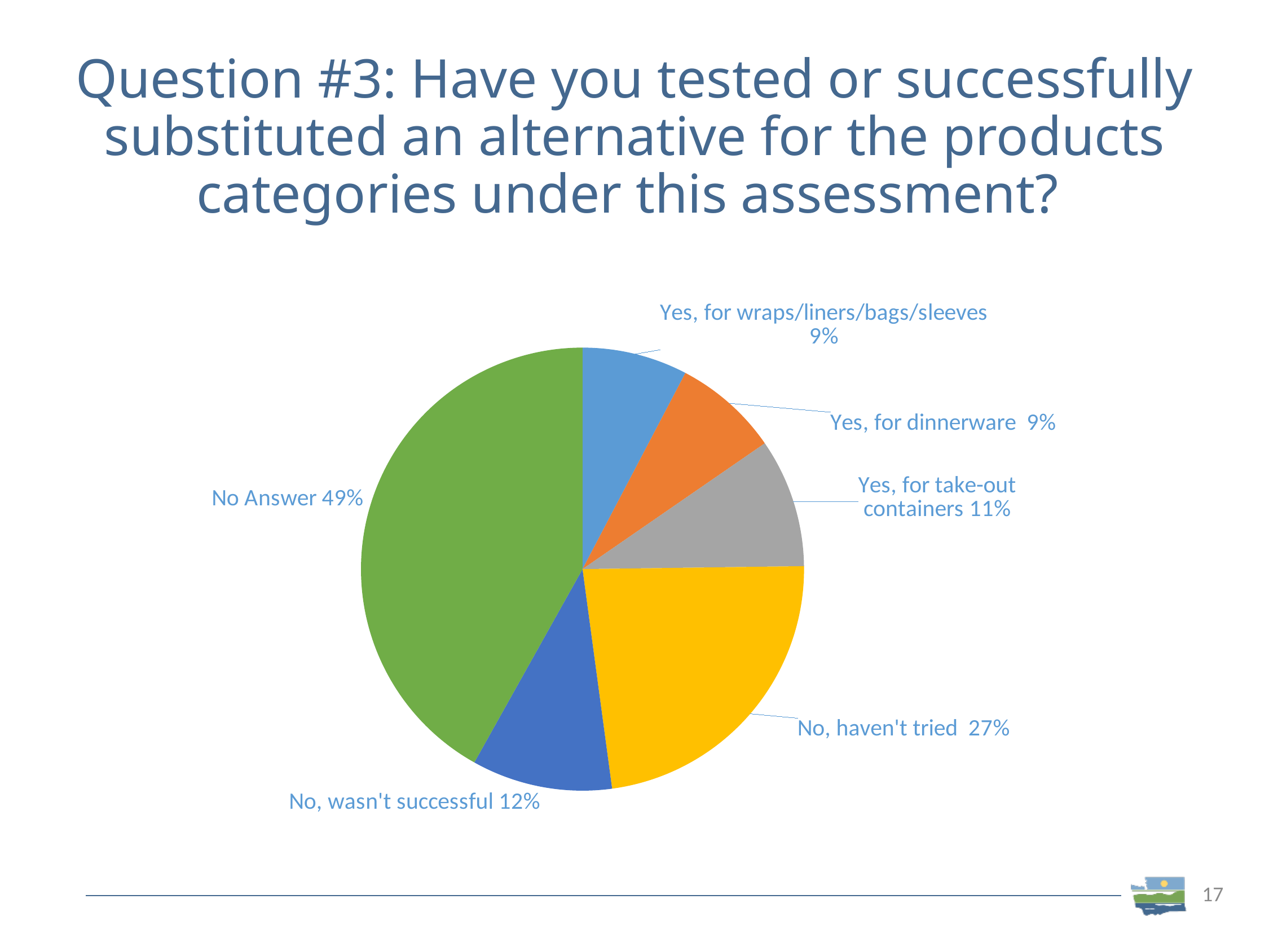
What is the difference in percentage points between "No Answer" and "No, haven't tried"? 22 What percentage is shown for "Yes, for take-out containers"? 11% Which category has the largest slice of the pie? No Answer What percentage is shown for "No, wasn't successful"? 12% What is the difference in percentage points between "No, haven't tried" and "Yes, for wraps/liners/bags/sleeves"? 18 What percentage is shown for "No, haven't tried"? 27% What share of the pie is labelled "No Answer"? 49% What colour is the "No Answer" slice? Green What kind of chart is shown on the slide? Pie chart Which is larger, "No, wasn't successful" or "Yes, for take-out containers"? No, wasn't successful How many slices does the pie chart have? 6 What percentage is shown for "Yes, for dinnerware"? 9%